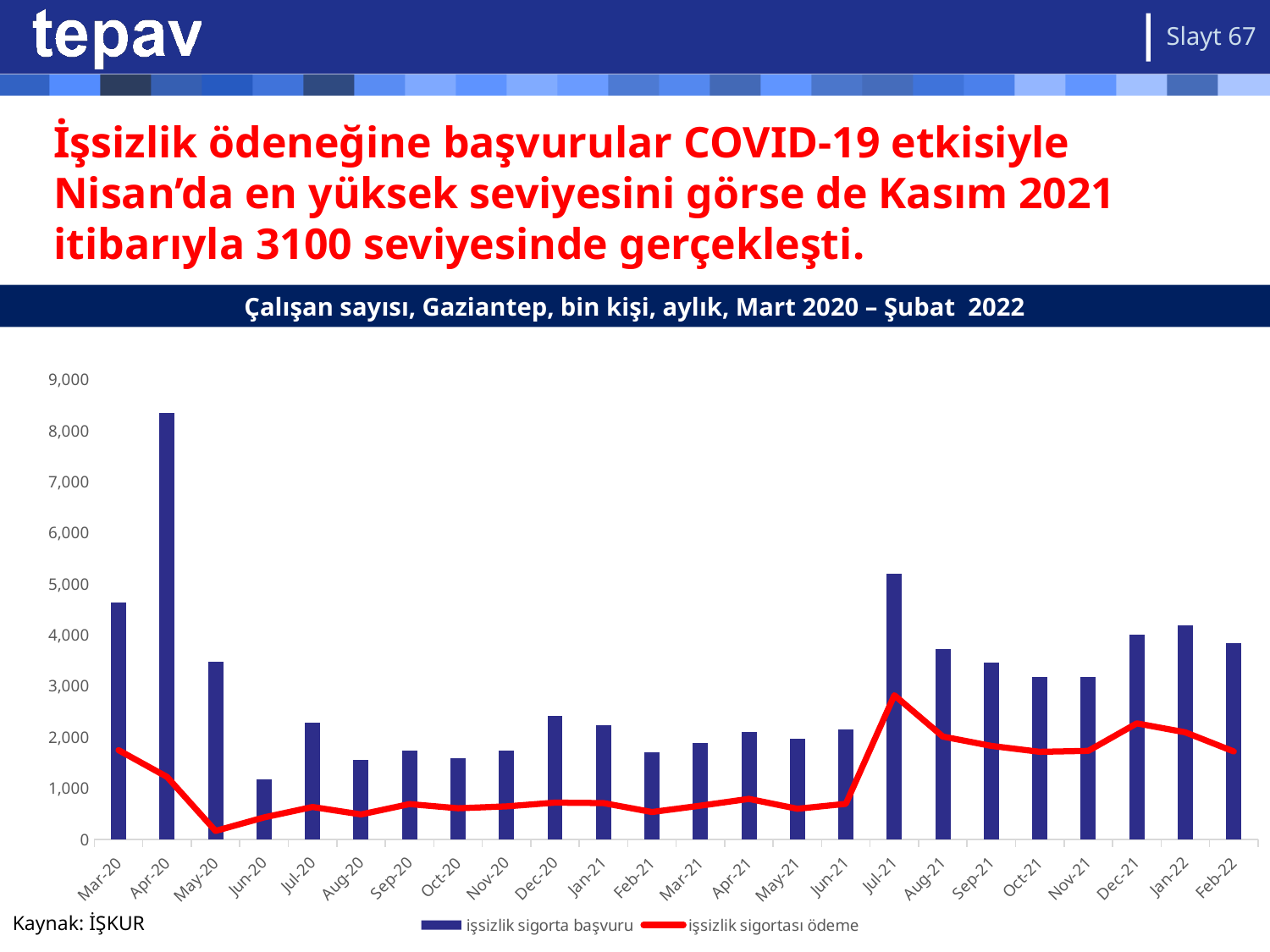
Is the işsizlik sigorta başvuru value for Apr-20 greater or less than 8,000? greater What is the source cited below the chart? İŞKUR How many series does the legend list? 2 How many months are plotted along the x axis? 24 Is the işsizlik sigorta başvuru value for Jul-21 greater or less than 5,000? greater What kind of chart is shown on the slide? A combined bar and line chart Which month has the highest bar for işsizlik sigorta başvuru? Apr-20 Is the işsizlik sigortası ödeme value for May-20 greater or less than 1,000? less Which month has the lowest bar for işsizlik sigorta başvuru? Jun-20 Which is larger, the işsizlik sigorta başvuru bar for Jul-21 or for Aug-21? Jul-21 Which is larger, the işsizlik sigorta başvuru bar for Mar-20 or for May-20? Mar-20